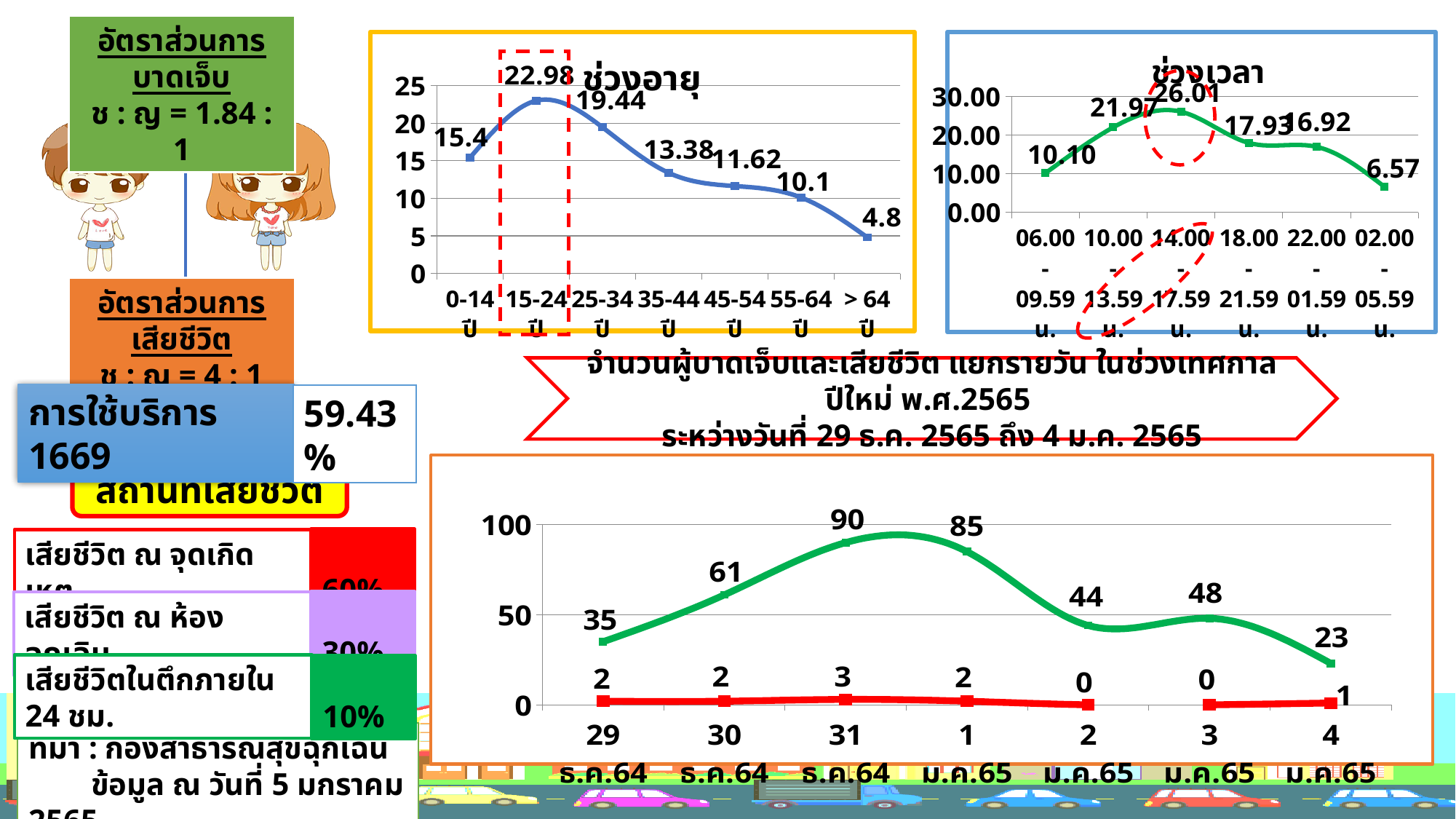
How many age groups are plotted in the ช่วงอายุ chart? 7 In the ช่วงเวลา chart, which time period has the lowest value? 02.00-05.59 น. In the ช่วงอายุ chart, which age group has the lowest value? > 64 ปี What type of chart is the ช่วงเวลา chart? line chart In the ช่วงอายุ chart, what is the value for the 15-24 ปี age group? 22.98 In the bottom chart (จำนวนผู้บาดเจ็บและเสียชีวิต แยกรายวัน), what is the difference between the green line values on 1 ม.ค.65 and 2 ม.ค.65? 41 In the ช่วงเวลา chart, is the value for 10.00-13.59 น. greater or less than 20.00? greater In the bottom chart (จำนวนผู้บาดเจ็บและเสียชีวิต แยกรายวัน), what is the value of the red line on 31 ธ.ค.64? 3 In the bottom chart (จำนวนผู้บาดเจ็บและเสียชีวิต แยกรายวัน), what is the value of the green line on 31 ธ.ค.64? 90 In the ช่วงอายุ chart, what is the difference between the values for 25-34 ปี and 35-44 ปี? 6.06 In the ช่วงเวลา chart, what is the value for the 14.00-17.59 น. time period? 26.01 In the bottom chart (จำนวนผู้บาดเจ็บและเสียชีวิต แยกรายวัน), on which date does the green line reach its highest value? 31 ธ.ค.64